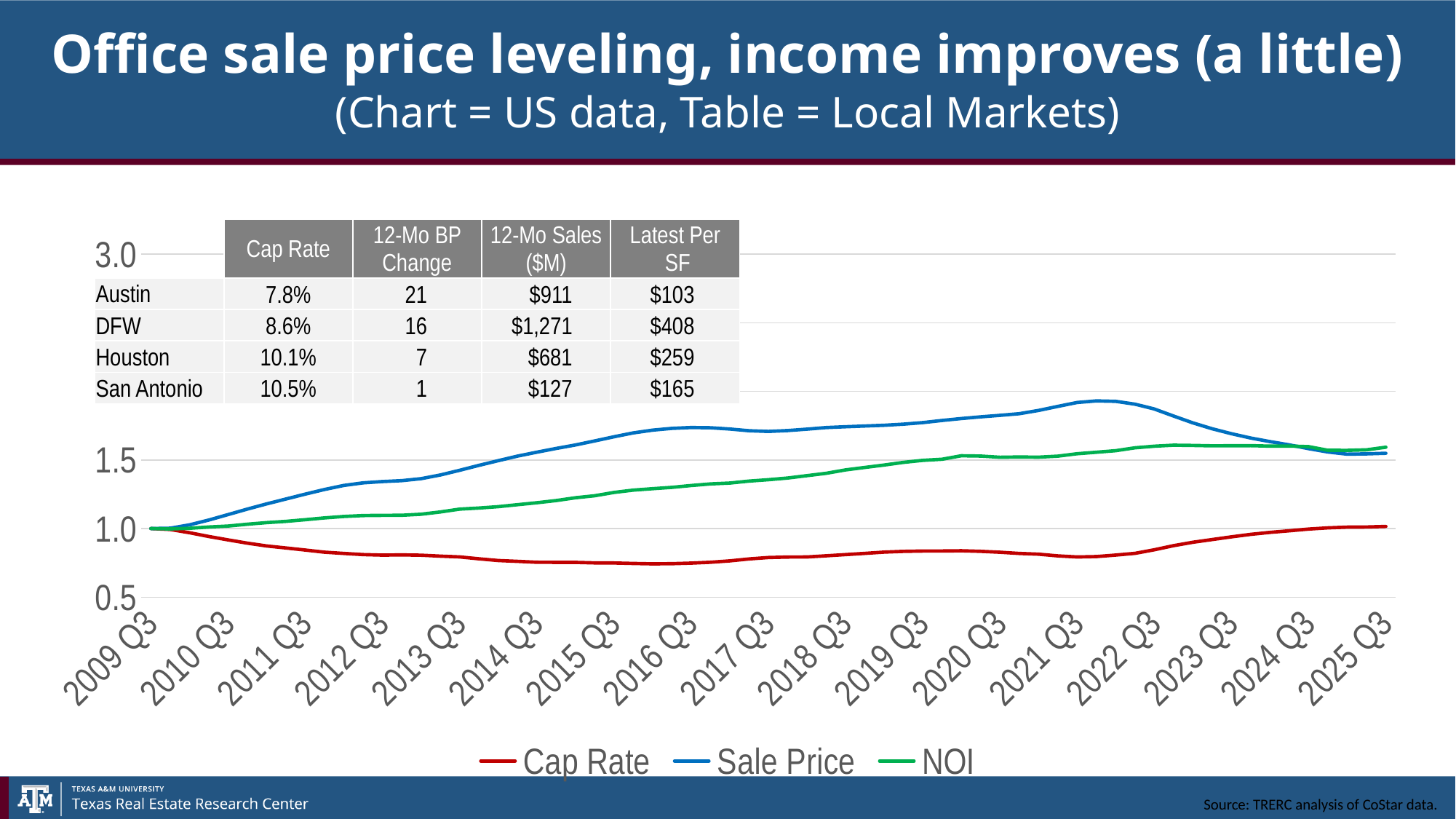
Is the value for Sale Price at 2022 Q3 greater or less than 1.5? greater How many quarter labels are shown along the x axis of the chart? 17 How many series does the chart legend list? 3 What kind of chart is shown on the slide? line chart At 2016 Q3, which is larger, Sale Price or NOI? Sale Price Is the value for NOI at 2012 Q3 greater or less than 1.5? less Does the Sale Price line rise or fall from 2022 Q3 to 2025 Q3? fall Which series is lowest at 2016 Q3? Cap Rate What colour is the NOI line in the chart? green Does the Sale Price line rise or fall from 2009 Q3 to 2022 Q3? rise Is the value for Cap Rate at 2016 Q3 greater or less than 1.0? less Which series is highest at 2022 Q3? Sale Price